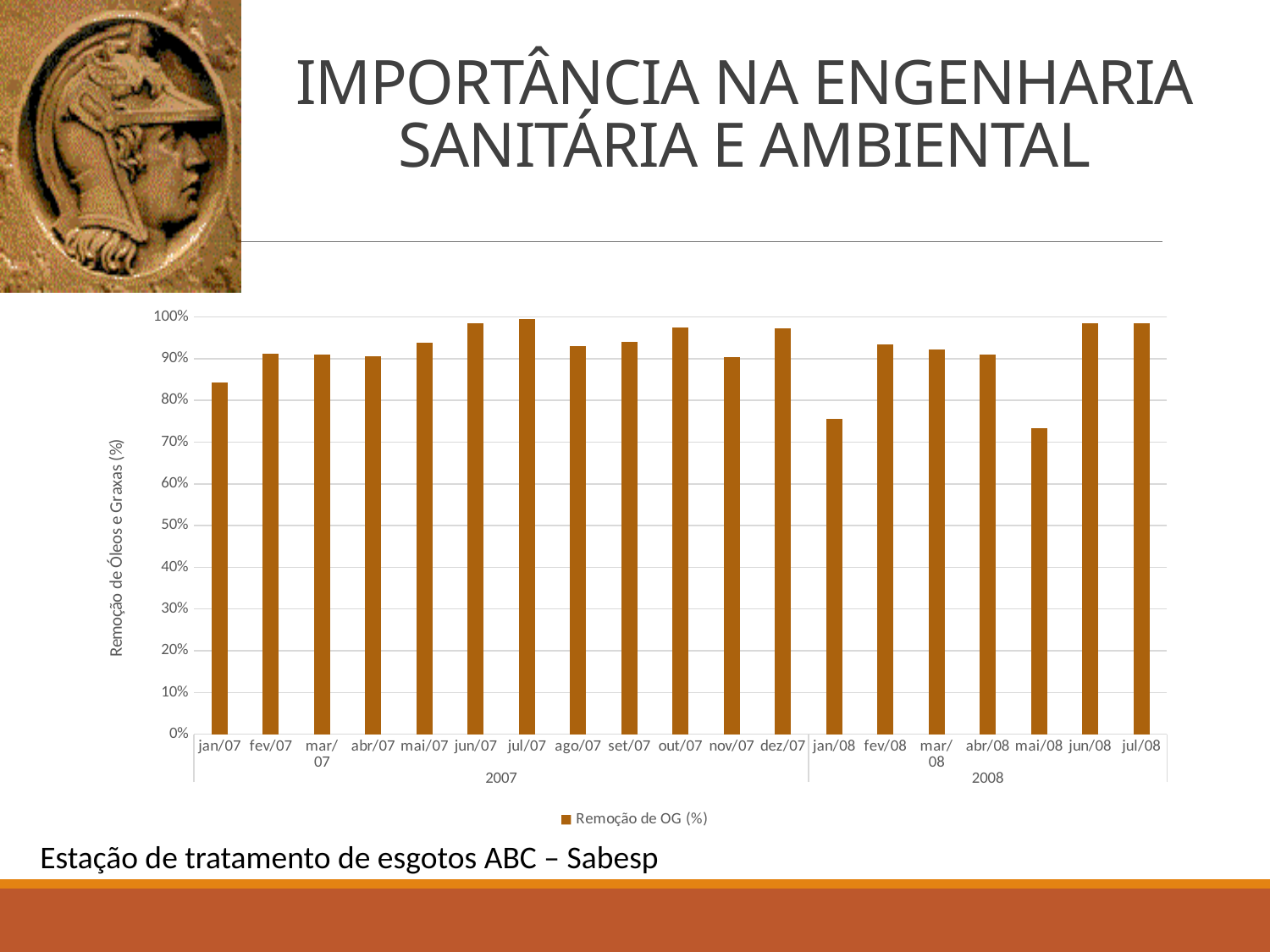
How many series does the chart legend list? 1 Is the value for jul/07 greater or less than 90%? greater Is the value for mai/08 greater or less than 80%? less Is the value for jan/07 greater or less than 90%? less What kind of chart is shown on the slide? bar chart How many months (bars) are plotted in the chart? 19 Which is larger, the value for mai/08 or the value for jun/08? jun/08 What is the title of the vertical axis of the chart? Remoção de Óleos e Graxas (%) Which is larger, the value for jan/07 or the value for fev/07? fev/07 Which month has the lowest value in the chart? mai/08 What is the legend entry for the series in the chart? Remoção de OG (%)